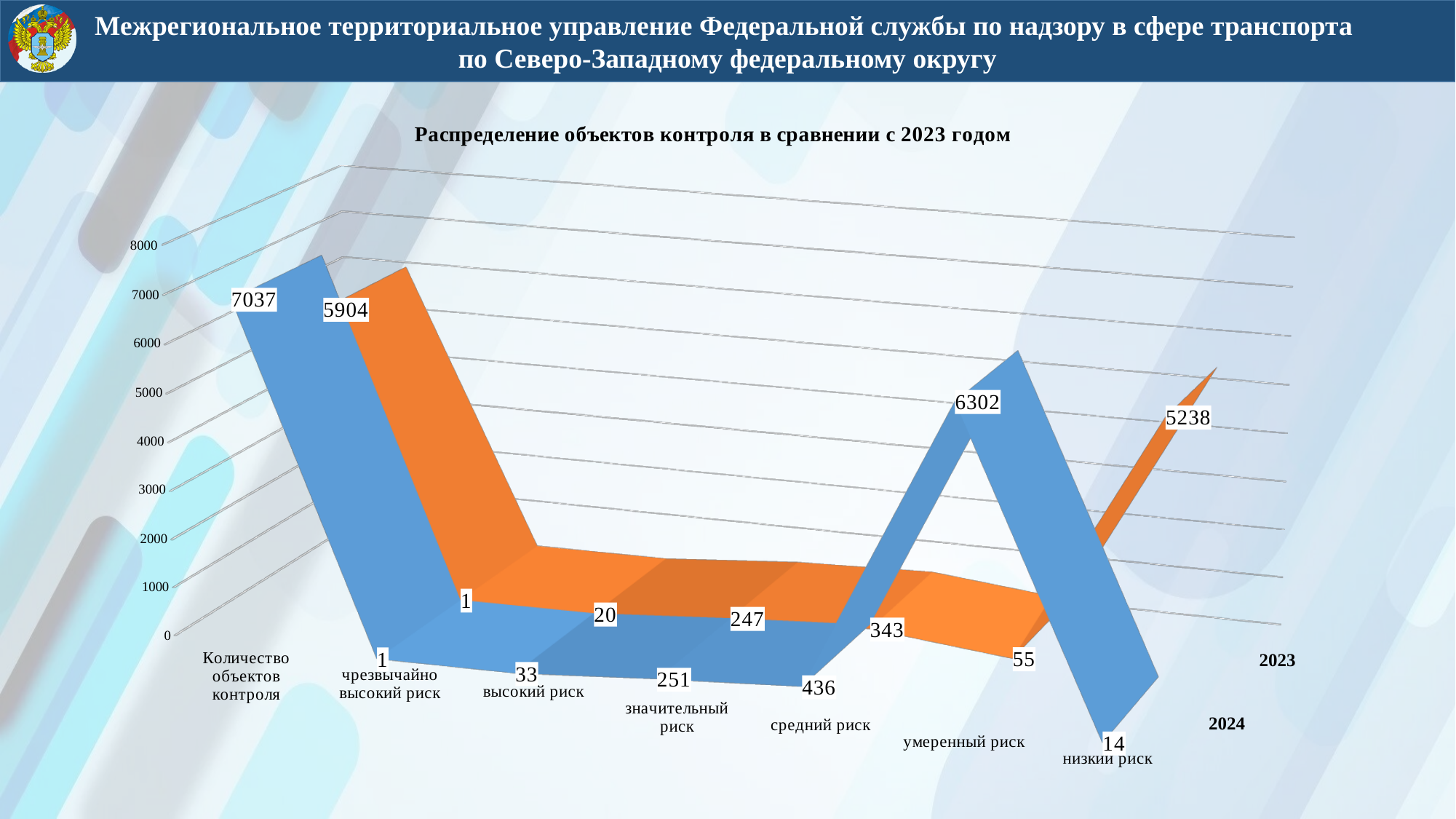
How many categories are shown along the x axis of the chart? 7 What is the value for 'Количество объектов контроля' in the 2024 series? 7037 Which is larger for 'низкий риск': the 2023 value or the 2024 value? 2023 What is the value for 'низкий риск' in the 2023 series? 5238 How many series does the chart show? 2 What is the difference between the 2024 and 2023 values for 'средний риск'? 93 What is the value for 'умеренный риск' in the 2024 series? 6302 What is the difference between the 2024 and 2023 values for 'Количество объектов контроля'? 1133 What kind of chart is shown on the slide? 3D line chart Which category has the lowest value in the 2024 series? чрезвычайно высокий риск What is the title of the chart? Распределение объектов контроля в сравнении с 2023 годом What is the value for 'Количество объектов контроля' in the 2023 series? 5904